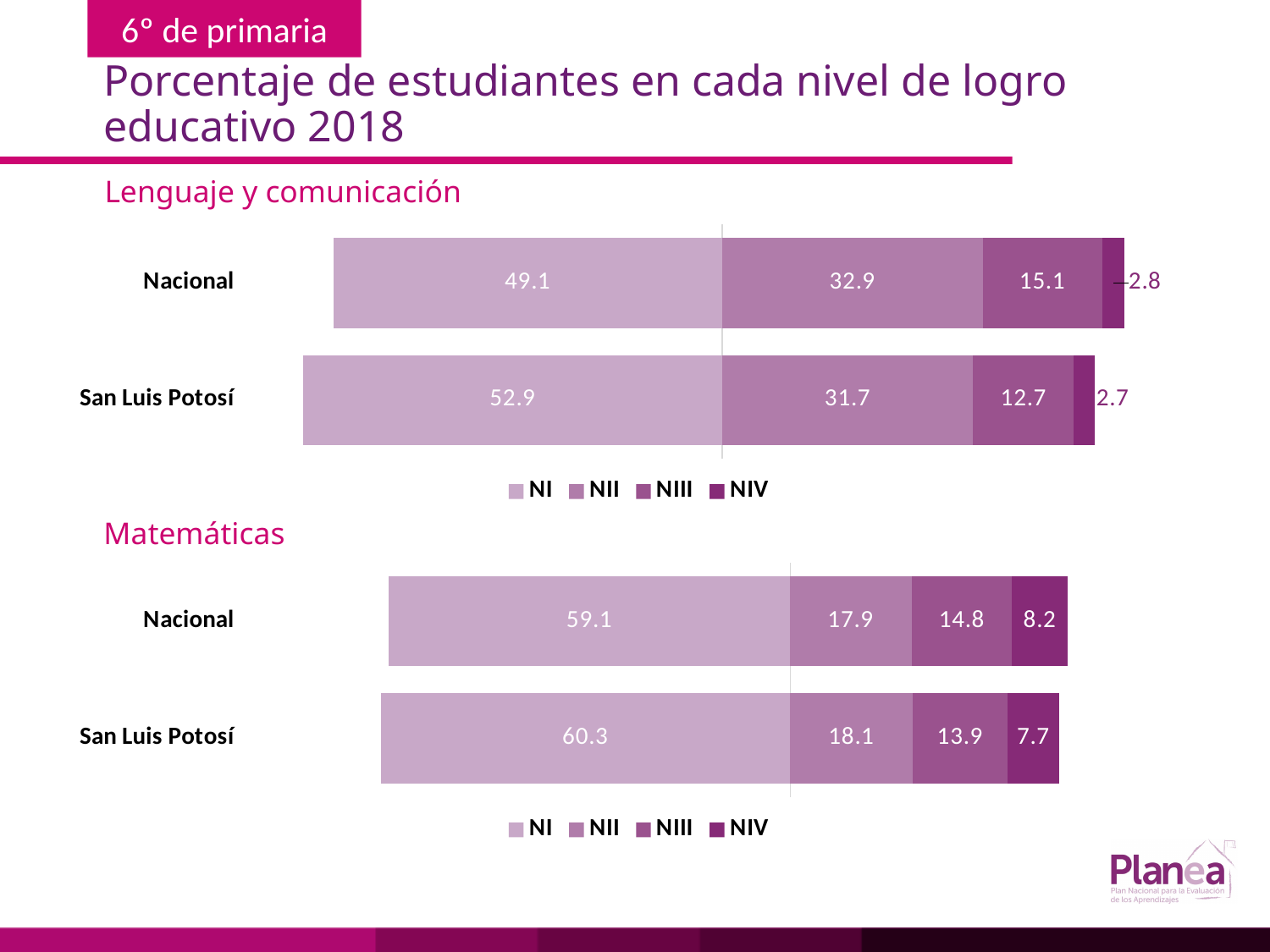
How many series does the legend of the Matemáticas chart list? 4 In the Matemáticas chart, which level has the highest value for Nacional? NI What type of chart is the Lenguaje y comunicación chart? Stacked bar chart In the Lenguaje y comunicación chart, which has the larger NII value, Nacional or San Luis Potosí? Nacional In the Matemáticas chart, what is the difference between the NI values for San Luis Potosí and Nacional? 1.2 In the Lenguaje y comunicación chart, what is the NI value for San Luis Potosí? 52.9 In the Matemáticas chart, what is the NIII value for Nacional? 14.8 In the Matemáticas chart, which has the larger NIV value, Nacional or San Luis Potosí? Nacional In the Lenguaje y comunicación chart, which level has the lowest value for San Luis Potosí? NIV In the Lenguaje y comunicación chart, what is the difference between the NIII values for Nacional and San Luis Potosí? 2.4 In the Matemáticas chart, what is the NII value for San Luis Potosí? 18.1 In the Lenguaje y comunicación chart, what is the NIV value for Nacional? 2.8